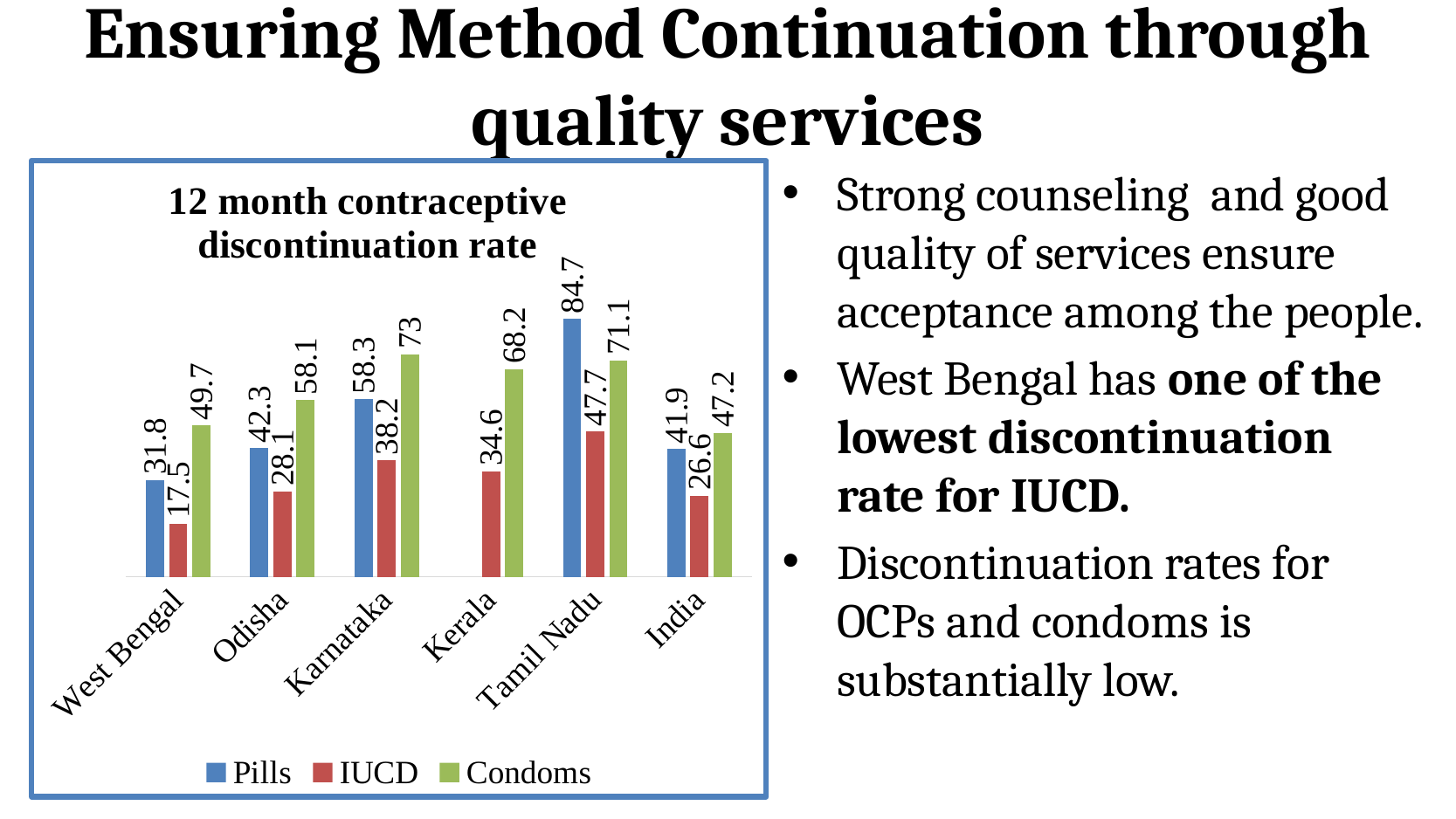
What is the discontinuation rate for Condoms in Karnataka? 73 Which state has the highest discontinuation rate for Pills? Tamil Nadu Which category has the lowest discontinuation rate for IUCD? West Bengal Which is larger: the Condoms discontinuation rate in Kerala or in Tamil Nadu? Tamil Nadu Which series is shown in red in the chart? IUCD What is the discontinuation rate for IUCD for India overall? 26.6 What is the discontinuation rate for Pills in Tamil Nadu? 84.7 How many categories (states/regions) are shown on the x axis of the chart? 6 What is the 12 month discontinuation rate for IUCD in West Bengal? 17.5 How many series does the chart legend list? 3 What type of chart is used to show the 12 month contraceptive discontinuation rate? Bar chart What is the difference between the Condoms and Pills discontinuation rates in Odisha? 15.8